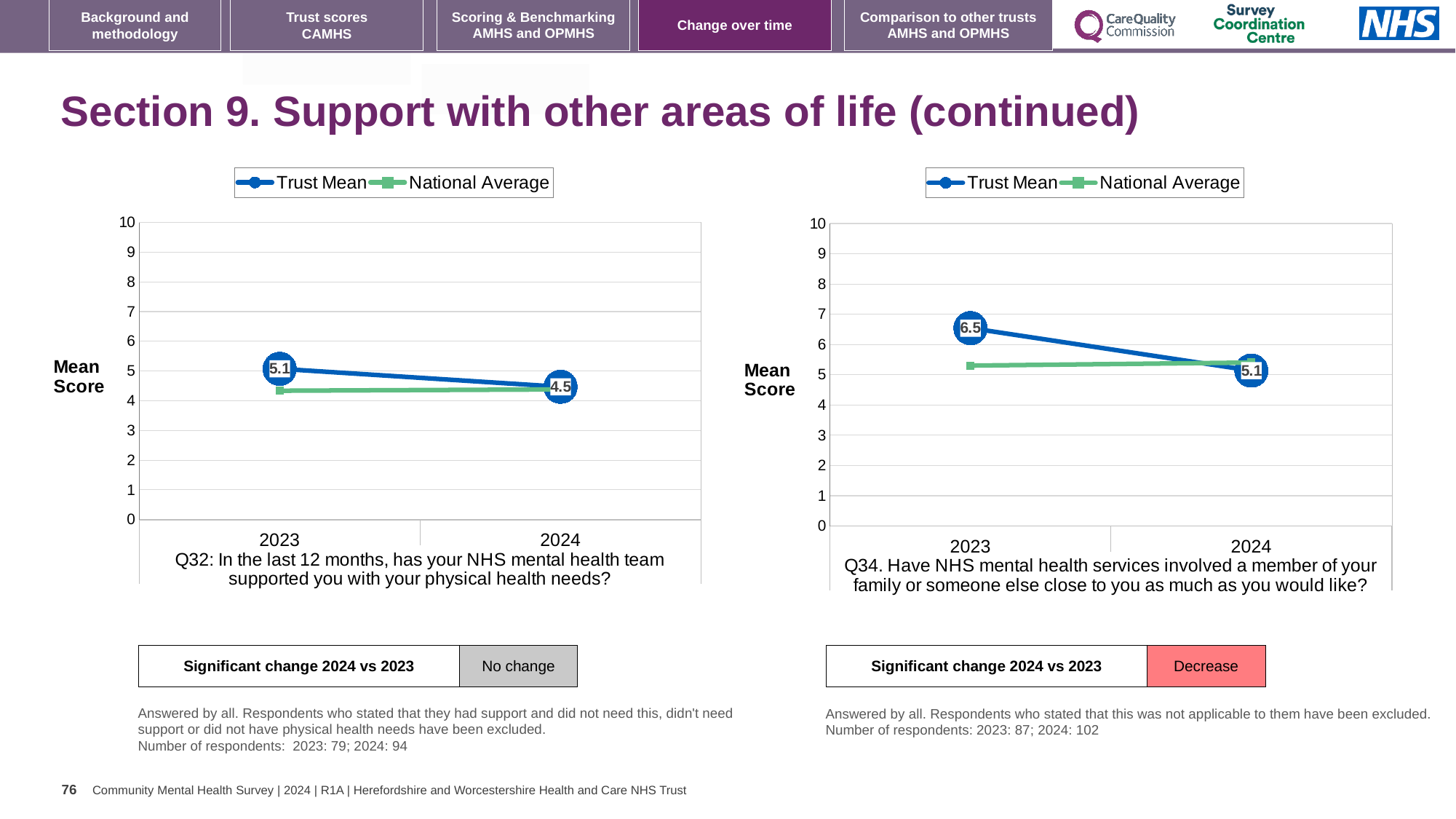
In the left chart (Q32), what is the Trust Mean for 2023? 5.1 In the left chart (Q32), what is the difference between the Trust Mean in 2023 and 2024? 0.6 How many series does the legend of the right chart (Q34) list? 2 How many years are shown on the x axis of the left chart (Q32)? 2 In the right chart (Q34), is the National Average for 2023 greater or less than 6? less In the right chart (Q34), what is the Trust Mean for 2023? 6.5 In the right chart (Q34), what is the Trust Mean for 2024? 5.1 In the right chart (Q34), by how much did the Trust Mean fall from 2023 to 2024? 1.4 In the left chart (Q32), what is the Trust Mean for 2024? 4.5 What type of chart is the left chart (Q32)? line chart In the right chart (Q34), does the Trust Mean rise or fall from 2023 to 2024? fall In the right chart (Q34), which is larger in 2023: the Trust Mean or the National Average? Trust Mean